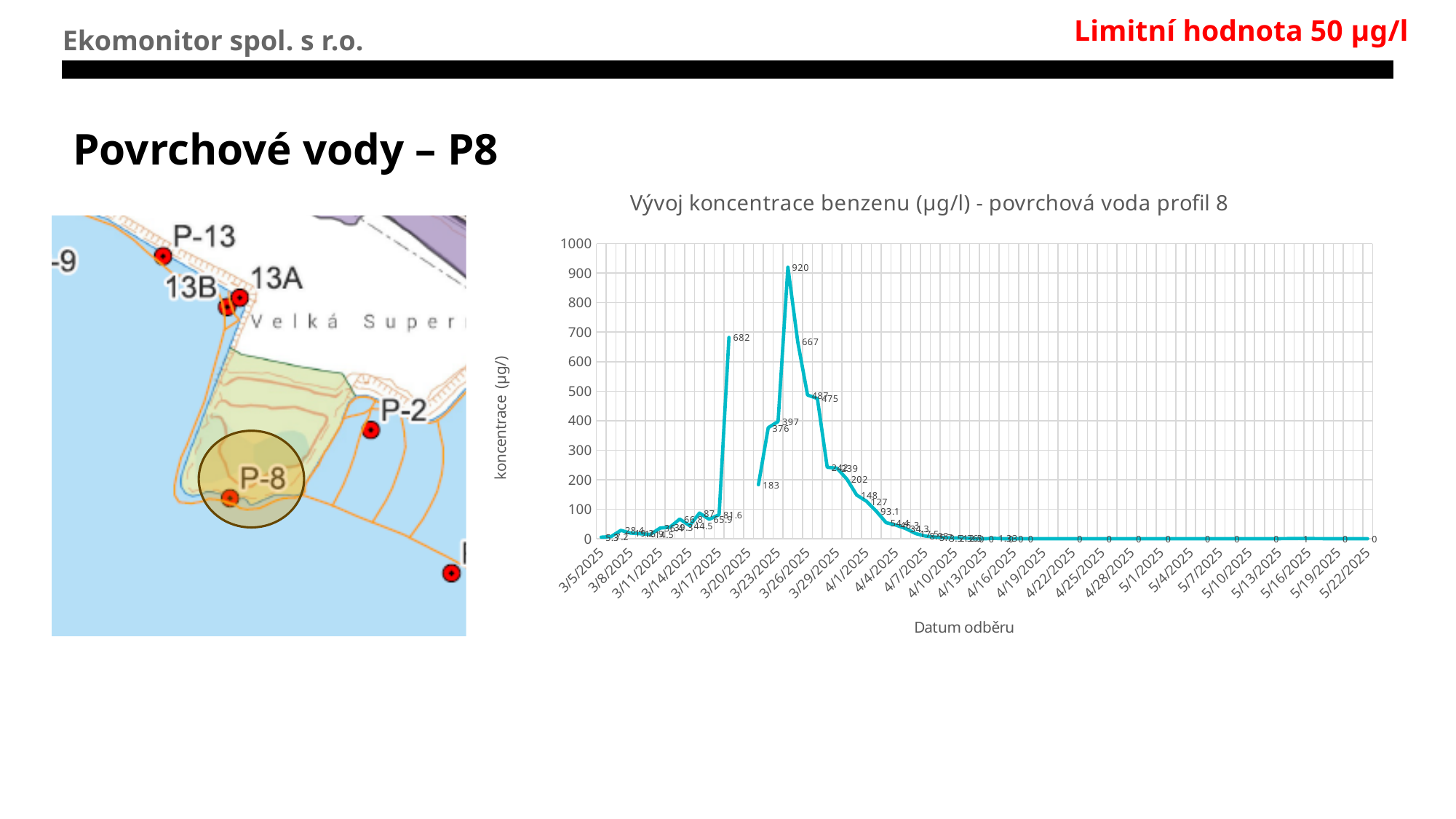
What is the title of the chart? Vývoj koncentrace benzenu (µg/l) - povrchová voda profil 8 What kind of chart is shown on the slide? line chart What is the value labelled for 5/22/2025? 0 What is the label of the x axis of the chart? Datum odběru After the peak of 920, do the values rise or fall along the x axis? fall What is the difference between the labelled values 487 and 475? 12 Is the value for 4/22/2025 greater or less than 100? less What is the highest value shown on the y axis of the chart? 1000 What is the highest benzene concentration value labelled on the chart? 920 Is the value for 3/5/2025 greater or less than 100? less Which labelled value is larger, 682 or 667? 682 What is the difference between the peak value of 920 and the labelled value of 682? 238